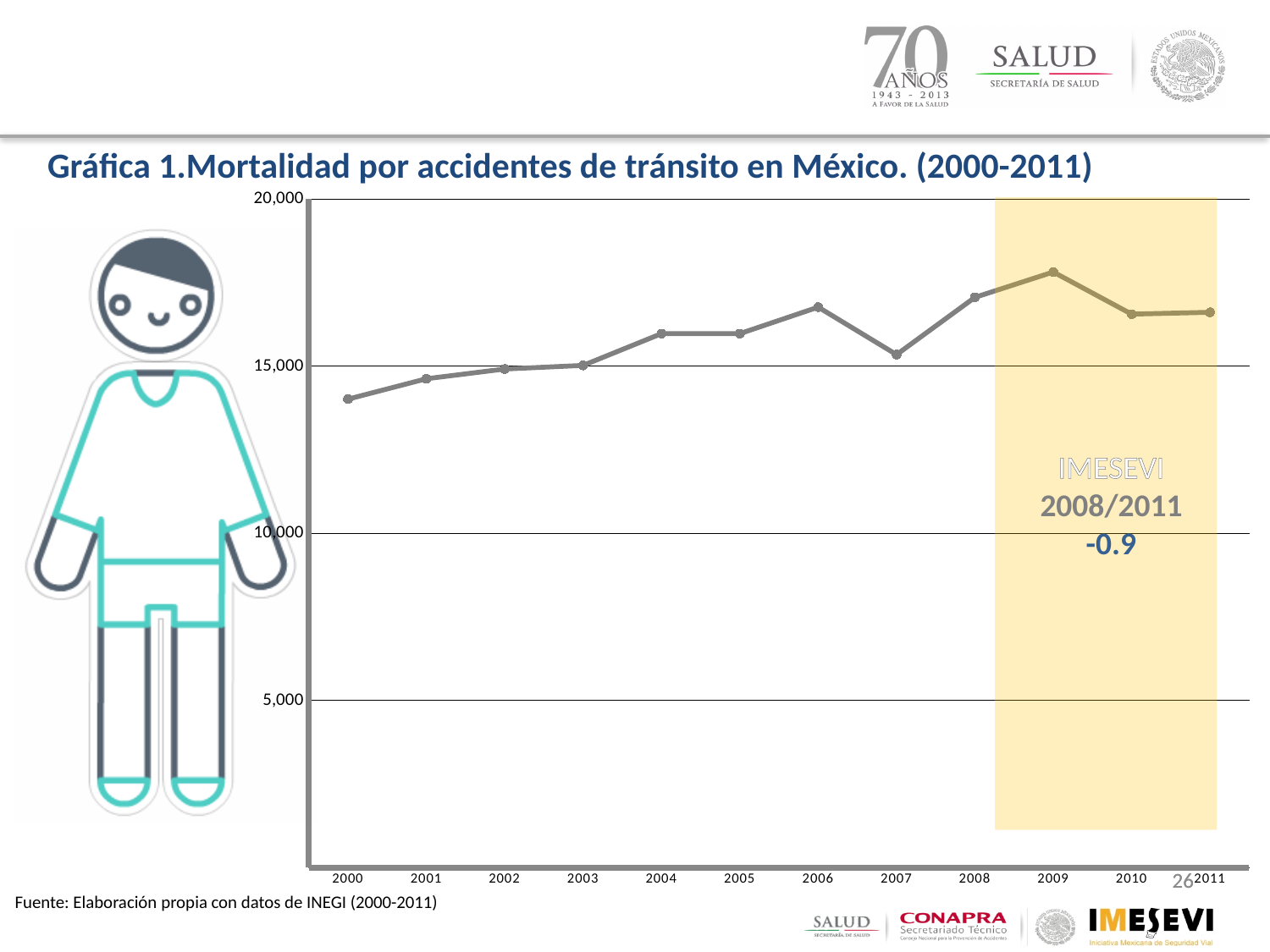
Is the value for 2000 greater or less than 15,000? less Do the values rise or fall from 2000 to 2006? rise How many years are plotted along the x axis of the chart? 12 Is the value for 2009 greater or less than 20,000? less What kind of chart is shown on the slide? line chart Which year has the highest mortality value in the chart? 2009 Is the value for 2004 greater or less than 15,000? greater What is the title of the chart? Gráfica 1.Mortalidad por accidentes de tránsito en México. (2000-2011) Which year has the larger value, 2009 or 2007? 2009 Do the values rise or fall from 2009 to 2010? fall Which year has the lowest mortality value in the chart? 2000